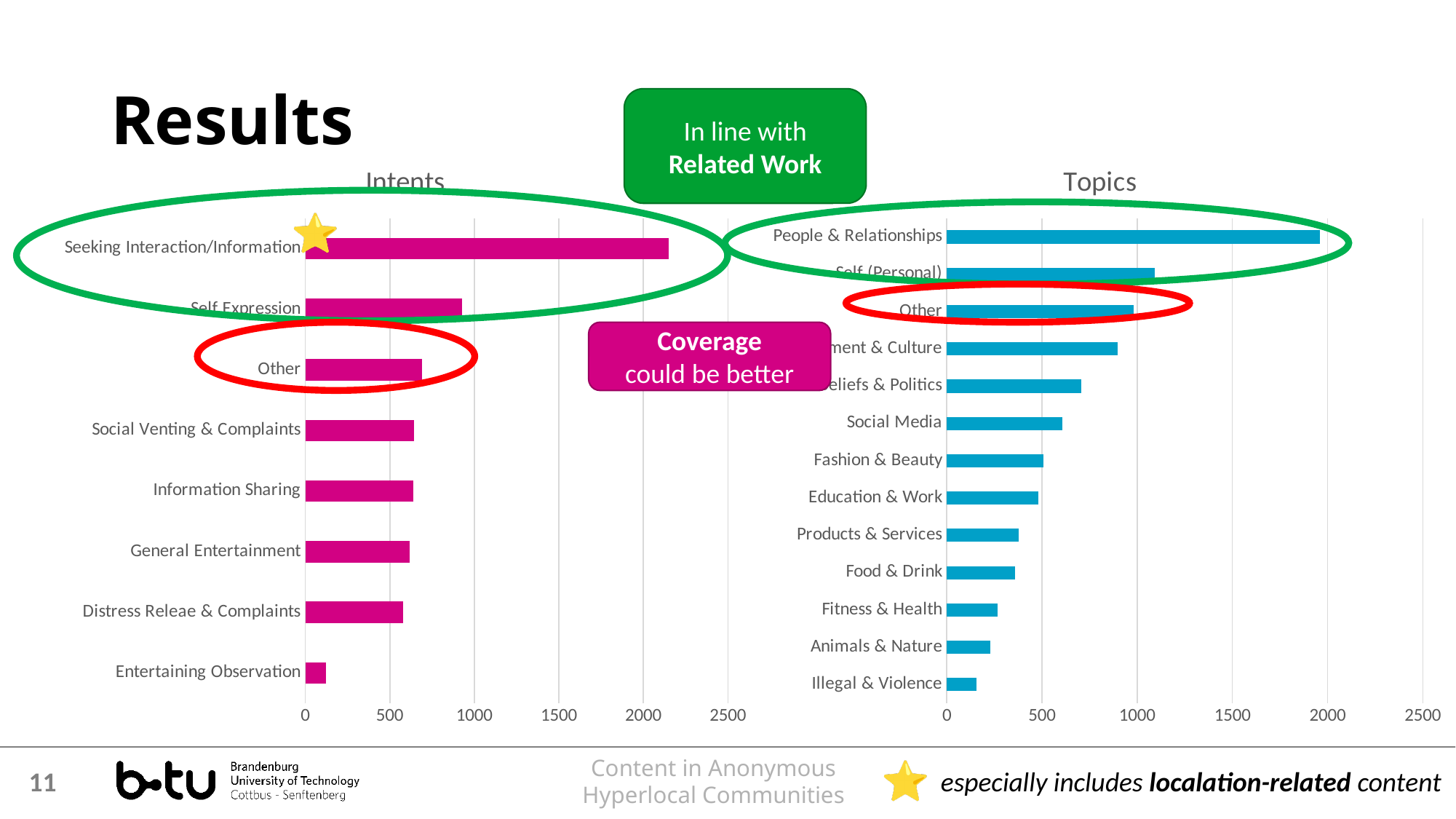
In the Intents chart, is the value for Seeking Interaction/Information greater or less than 2000? greater How many categories does the Intents chart show? 8 In the Topics chart, is the value for People & Relationships greater or less than 1500? greater What kind of chart is the Intents chart? bar chart In the Intents chart, is the value for Self Expression greater or less than 1000? less In the Topics chart, which is larger, Food & Drink or Fitness & Health? Food & Drink In the Intents chart, which category has the highest value? Seeking Interaction/Information In the Topics chart, which category has the lowest value? Illegal & Violence In the Intents chart, which category has the lowest value? Entertaining Observation What is the title of the chart on the right side of the slide? Topics In the Topics chart, which category has the highest value? People & Relationships